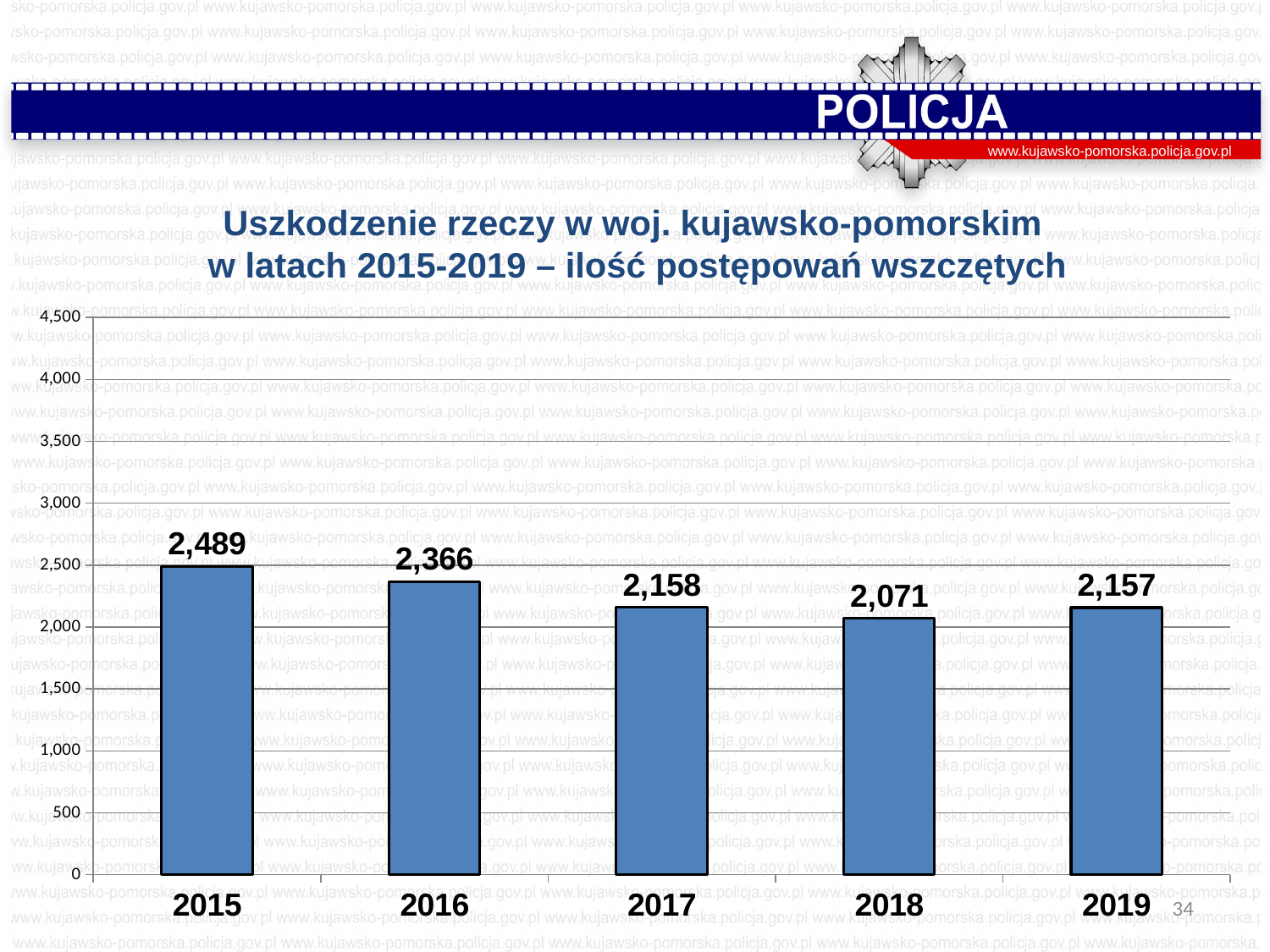
What is the difference between the values for 2015 and 2016? 123 What type of chart is shown on the slide? bar chart What is the value for 2019? 2,157 How many years are shown on the x axis of the chart? 5 What is the title of the chart? Uszkodzenie rzeczy w woj. kujawsko-pomorskim w latach 2015-2019 – ilość postępowań wszczętych Which year has the highest value? 2015 What is the value for 2015? 2,489 What is the value for 2018? 2,071 Is the value for 2017 greater or less than 2,500? less Which is larger, the value for 2016 or the value for 2018? 2016 Which year has the lowest value? 2018 What is the value for 2016? 2,366